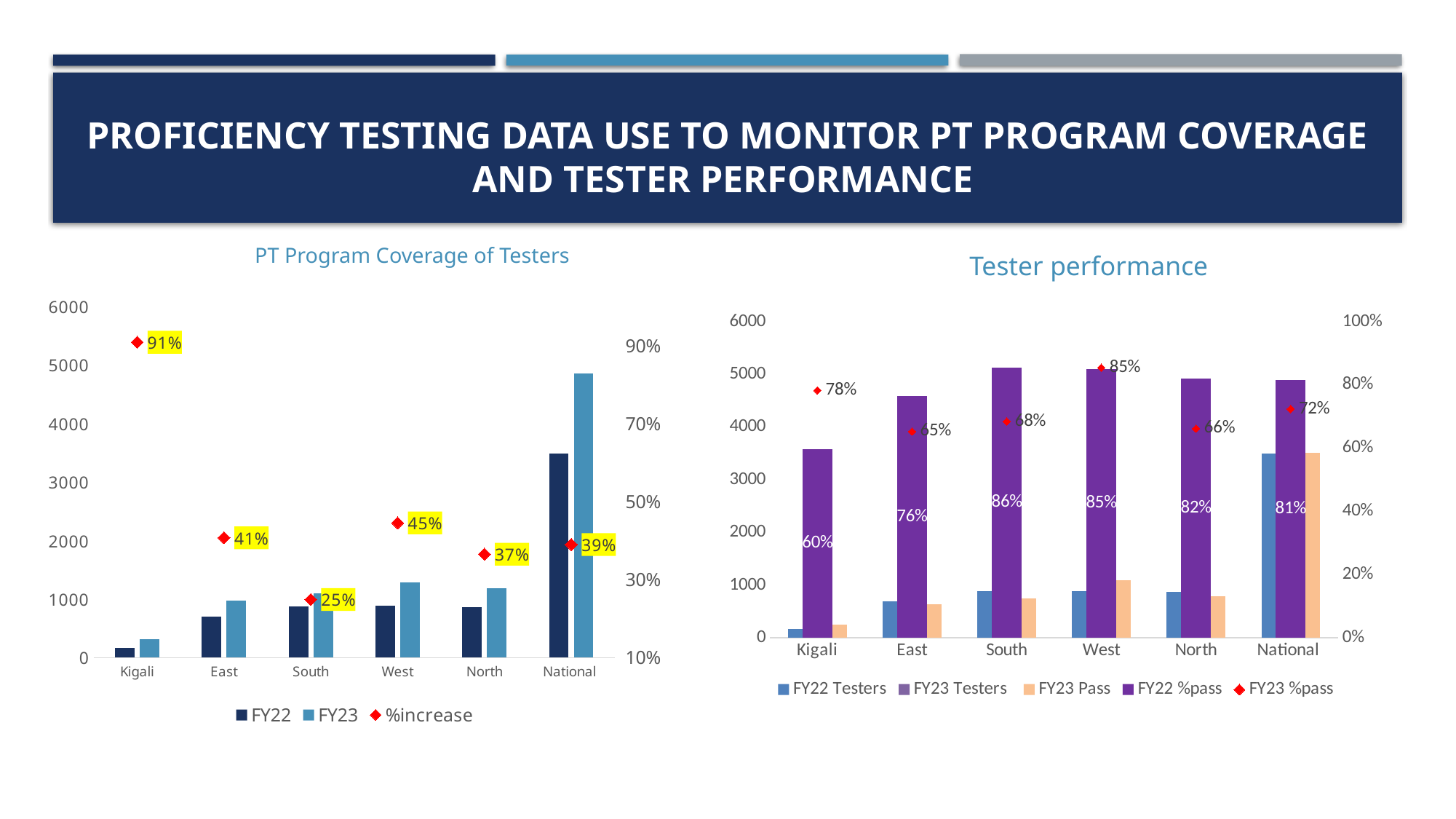
In the PT Program Coverage of Testers chart, which category has the lowest %increase? South In the Tester performance chart, for East, which is larger: FY22 %pass or FY23 %pass? FY22 %pass How many series does the legend of the Tester performance chart list? 5 In the PT Program Coverage of Testers chart, what is the %increase for Kigali? 91% How many categories are shown on the x axis of the PT Program Coverage of Testers chart? 6 In the Tester performance chart, which category has the lowest FY22 %pass? Kigali In the PT Program Coverage of Testers chart, what is the difference between the %increase for Kigali and the %increase for South? 66% In the PT Program Coverage of Testers chart, which category has the highest %increase? Kigali How many series does the legend of the PT Program Coverage of Testers chart list? 3 In the Tester performance chart, what is the FY22 %pass for South? 86% In the Tester performance chart, what is the FY23 %pass for Kigali? 78%